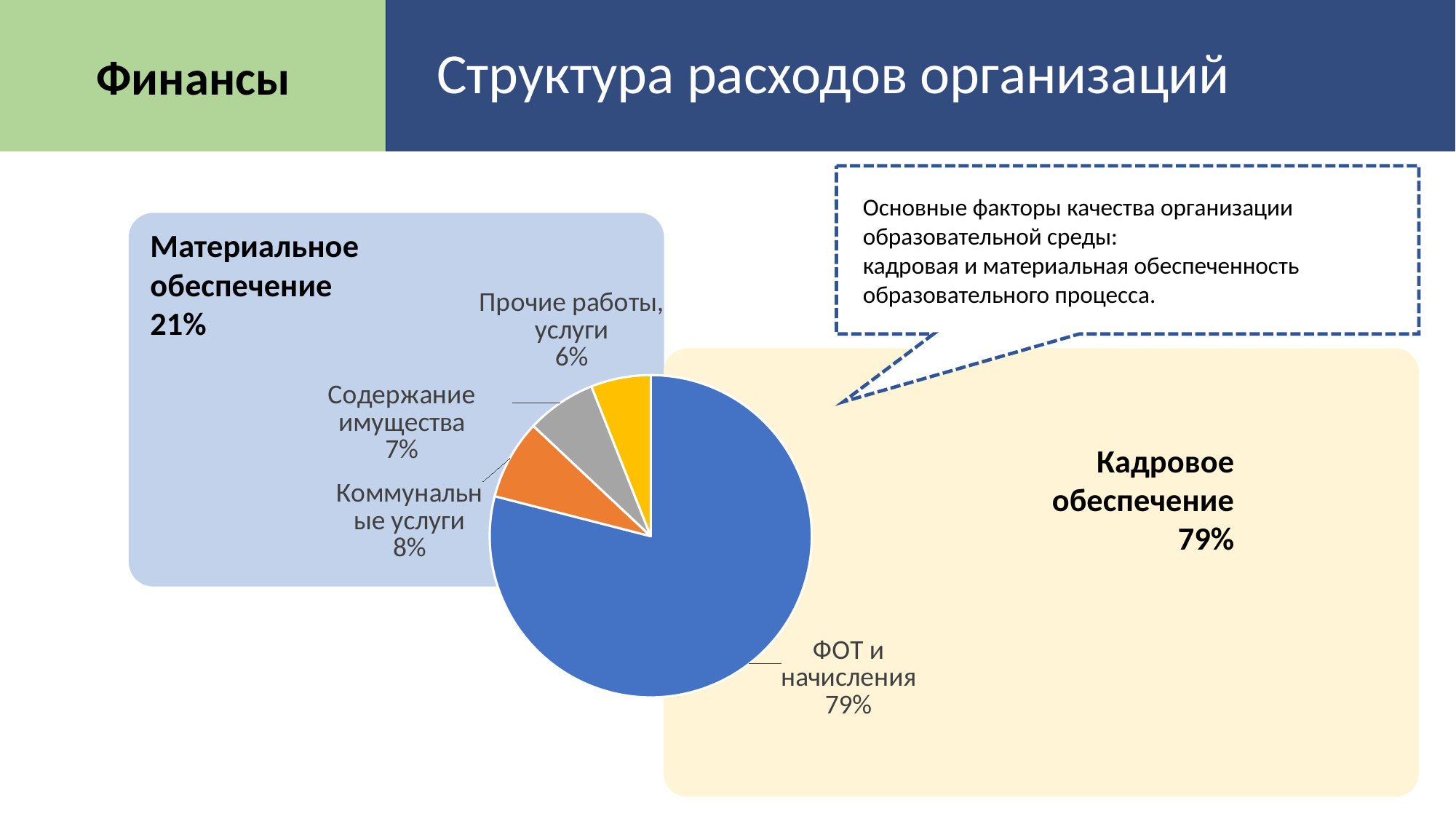
How many slices does the pie chart have? 4 What is the combined share of "Коммунальные услуги", "Содержание имущества" and "Прочие работы, услуги"? 21% What kind of chart is shown on the slide? pie chart What colour is the slice for "ФОТ и начисления"? blue Which category has the smallest slice of the pie? Прочие работы, услуги What share of expenses does "Прочие работы, услуги" account for? 6% Which is larger: the share for "Коммунальные услуги" or for "Прочие работы, услуги"? Коммунальные услуги What share of expenses does "Коммунальные услуги" account for? 8% Which category has the largest slice of the pie? ФОТ и начисления What is the difference in percentage points between "ФОТ и начисления" and "Коммунальные услуги"? 71 What share of expenses does "Содержание имущества" account for? 7% What share of expenses does "ФОТ и начисления" account for? 79%